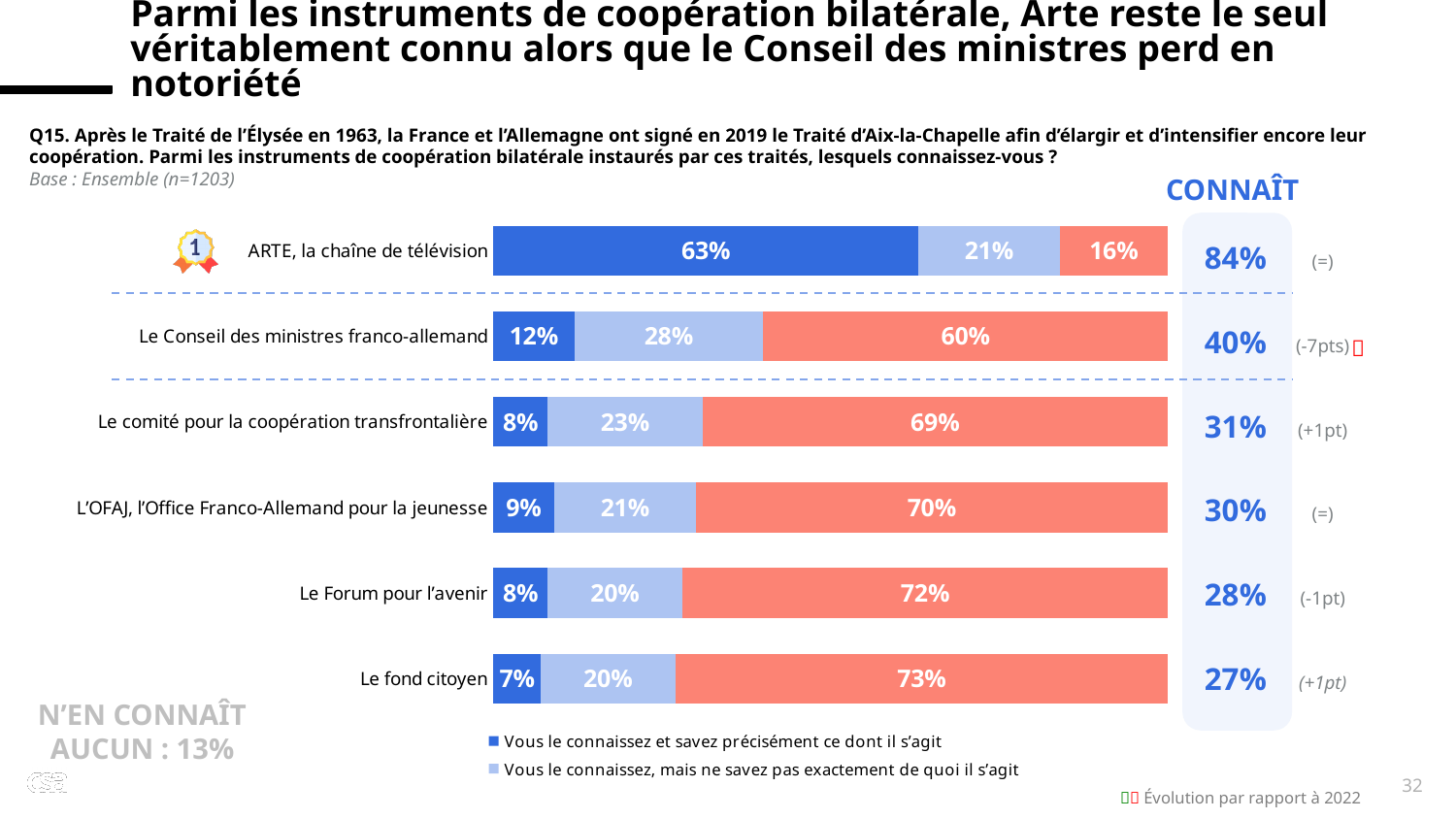
Which has a larger dark blue segment: Le Conseil des ministres franco-allemand or L'OFAJ, l'Office Franco-Allemand pour la jeunesse? Le Conseil des ministres franco-allemand What is the difference between the 'CONNAÎT' totals of ARTE, la chaîne de télévision and Le Conseil des ministres franco-allemand? 44 points Which instrument has the lowest 'CONNAÎT' total? Le fond citoyen What percentage of respondents say they know ARTE, la chaîne de télévision, and know precisely what it is (dark blue segment)? 63% What is the sum of the dark blue and light blue segments for Le comité pour la coopération transfrontalière? 31% Which instrument has the highest 'CONNAÎT' total? ARTE, la chaîne de télévision What is the value of the salmon (right-hand) segment for Le fond citoyen? 73% What change versus 2022 is indicated next to the 'CONNAÎT' total for Le Conseil des ministres franco-allemand? -7pts How many instruments (categories) are plotted in the chart? 6 What kind of chart is shown on the slide? bar chart What percentage of respondents know none of the instruments, according to the text at the bottom left of the slide? 13% What is the 'CONNAÎT' total shown for Le Conseil des ministres franco-allemand? 40%